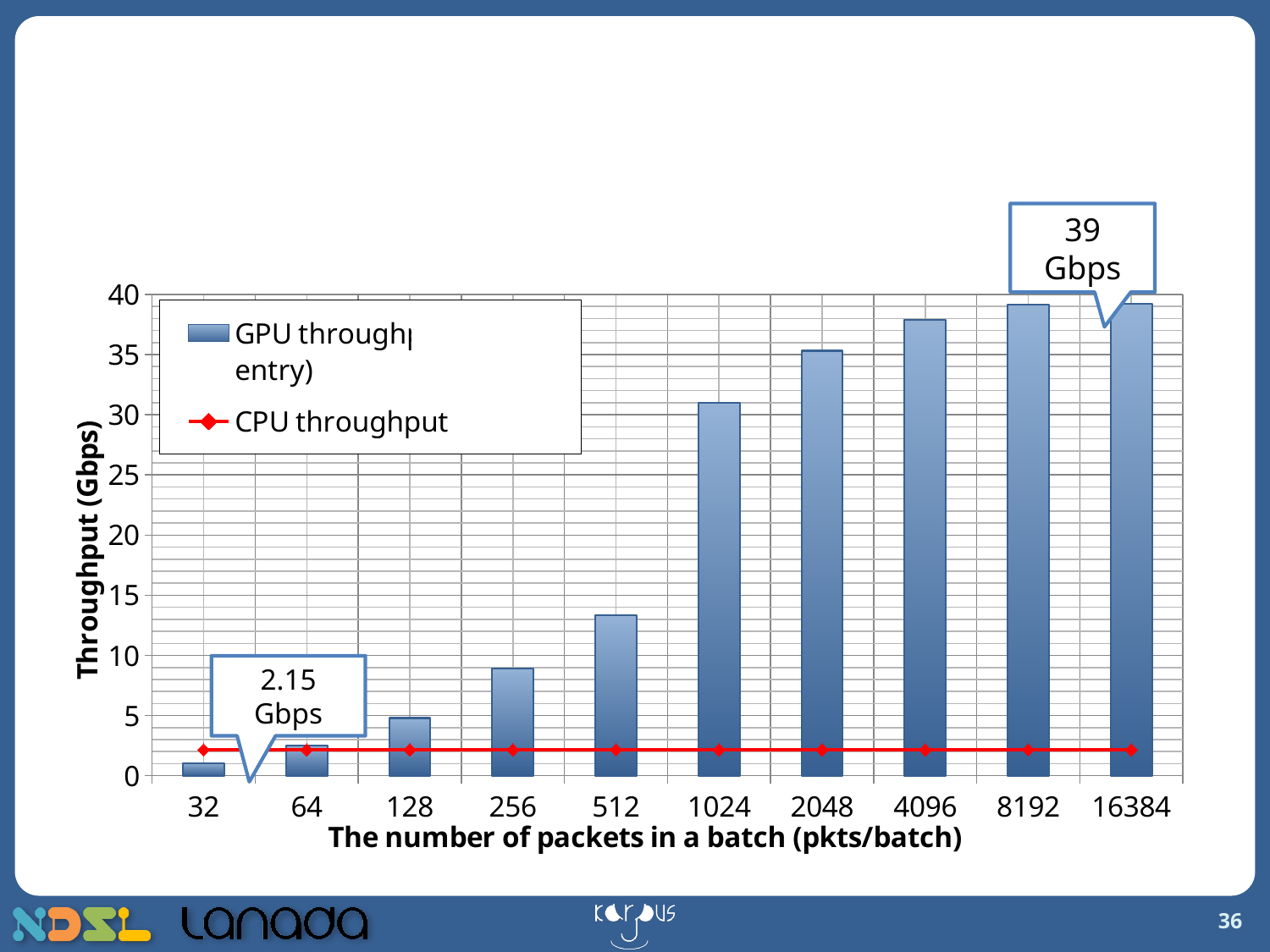
How many series does the legend list? 2 What kind of chart is used to show GPU throughput on this slide? bar chart Is the GPU throughput at 64 pkts/batch greater or less than 5 Gbps? less What is the difference between the labelled GPU throughput at 16384 pkts/batch and the labelled CPU throughput? 36.85 Gbps What is the title of the y axis? Throughput (Gbps) What is the GPU throughput at 16384 pkts/batch, as labelled on the slide? 39 Gbps Which batch size has the lowest GPU throughput? 32 Which has the higher GPU throughput, 256 pkts/batch or 512 pkts/batch? 512 pkts/batch How many batch-size categories are shown on the x axis? 10 What is the CPU throughput, as labelled on the slide? 2.15 Gbps How does GPU throughput change as the number of packets in a batch increases? It rises Is the GPU throughput at 512 pkts/batch greater or less than 10 Gbps? greater